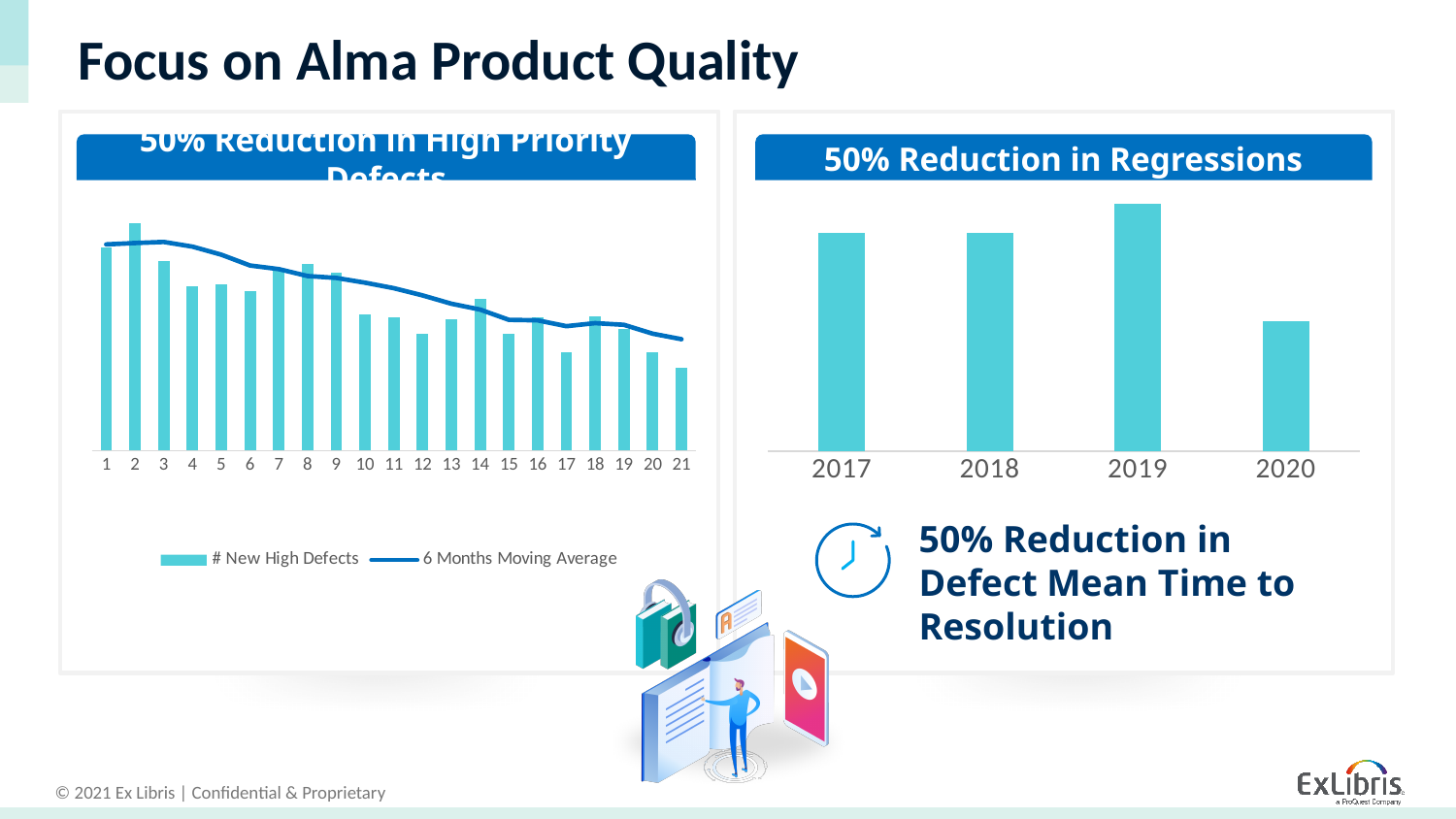
In the '50% Reduction in Regressions' chart, which year has the lowest bar? 2020 In the '50% Reduction in Regressions' chart, how many years are shown on the x axis? 4 In the '50% Reduction in High Priority Defects' chart, which category has the tallest bar? 2 In the '50% Reduction in High Priority Defects' chart, how many categories are shown on the x axis? 21 In the '50% Reduction in High Priority Defects' chart, which is larger, the bar for category 1 or the bar for category 21? 1 What kind of chart is the '50% Reduction in Regressions' chart? Bar chart In the '50% Reduction in Regressions' chart, which year has the highest bar? 2019 In the '50% Reduction in High Priority Defects' chart, does the 6 Months Moving Average line generally rise or fall from left to right? Fall In the '50% Reduction in Regressions' chart, which is larger, the value for 2019 or the value for 2020? 2019 In the '50% Reduction in High Priority Defects' chart, what are the two legend entries? # New High Defects; 6 Months Moving Average In the '50% Reduction in High Priority Defects' chart, how many series does the legend list? 2 In the '50% Reduction in High Priority Defects' chart, which category has the shortest bar? 21